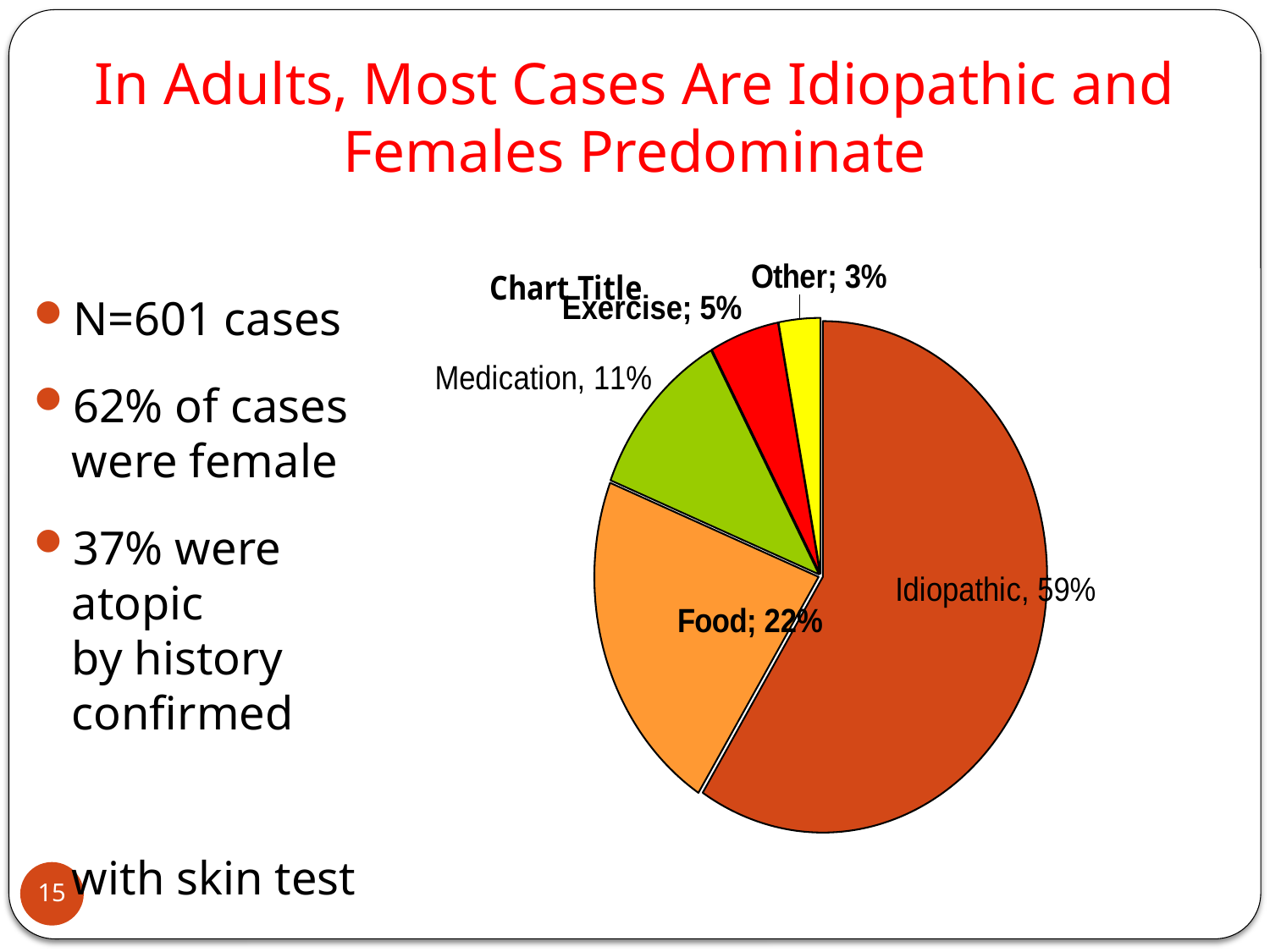
What is the difference in percentage points between Idiopathic and Food? 37 Which category has the smallest share of the pie? Other What percentage of cases are attributed to Food? 22% What kind of chart is shown on the slide? pie chart Which category has the largest share of the pie? Idiopathic What percentage of cases fall under Other? 3% How many categories are shown in the pie chart? 5 What percentage of cases are Idiopathic? 59% What percentage of cases are attributed to Medication? 11% What colour is the Idiopathic slice? dark orange-brown Which is larger, the share for Medication or the share for Exercise? Medication What percentage of cases are attributed to Exercise? 5%